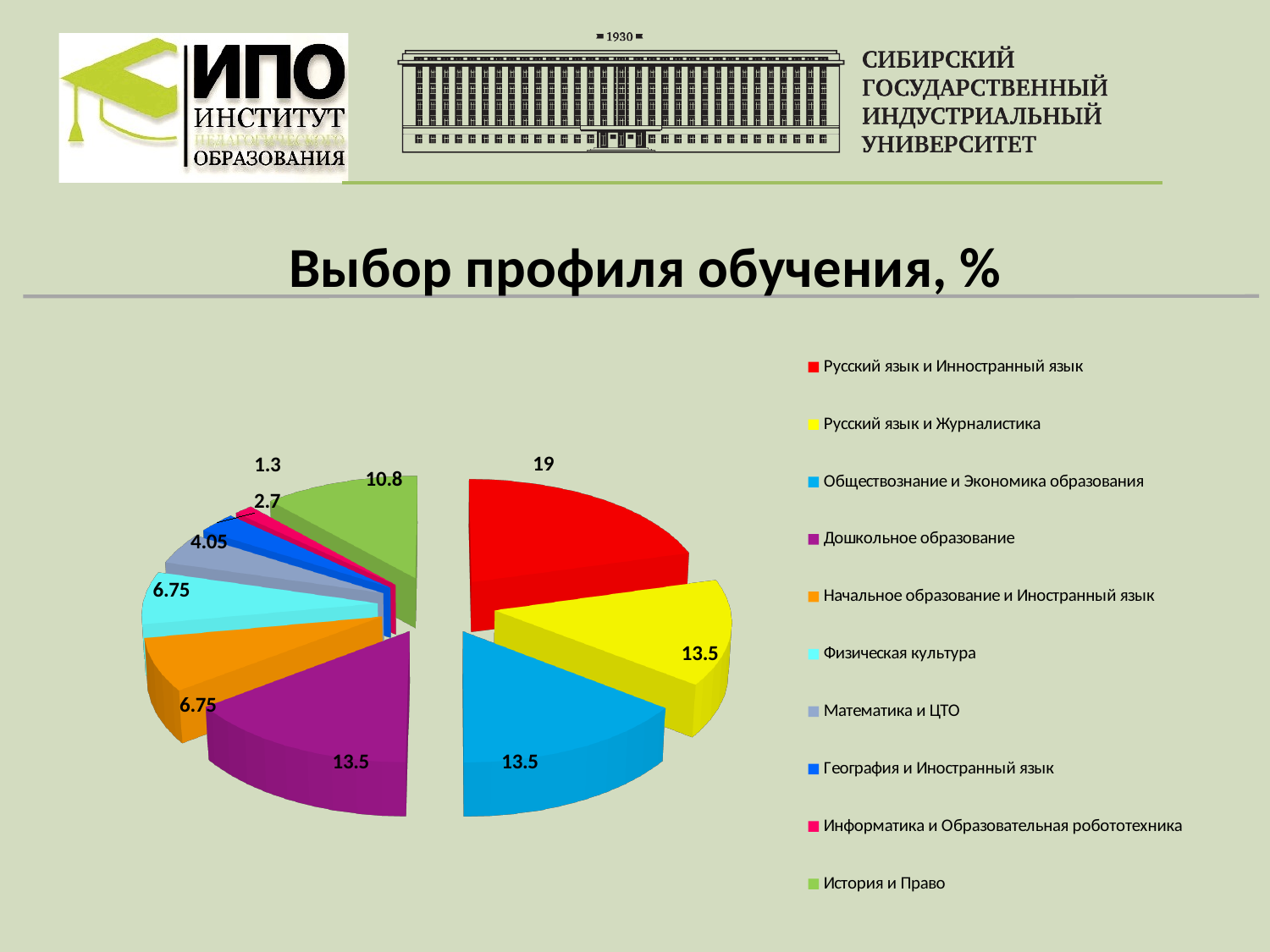
What is the value for Русский язык и Иностранный язык? 19 What is the title of the chart? Выбор профиля обучения, % What kind of chart is shown on the slide? pie chart What is the value for Информатика и Образовательная робототехника? 1.3 What is the difference between the values for Русский язык и Иностранный язык and История и Право? 8.2 What is the value for География и Иностранный язык? 2.7 Which is larger, the value for Физическая культура or the value for Математика и ЦТО? Физическая культура Which category has the largest slice of the pie? Русский язык и Иностранный язык What is the value for История и Право? 10.8 What is the value for Математика и ЦТО? 4.05 Which category has the smallest slice of the pie? Информатика и Образовательная робототехника How many entries does the chart legend list? 10